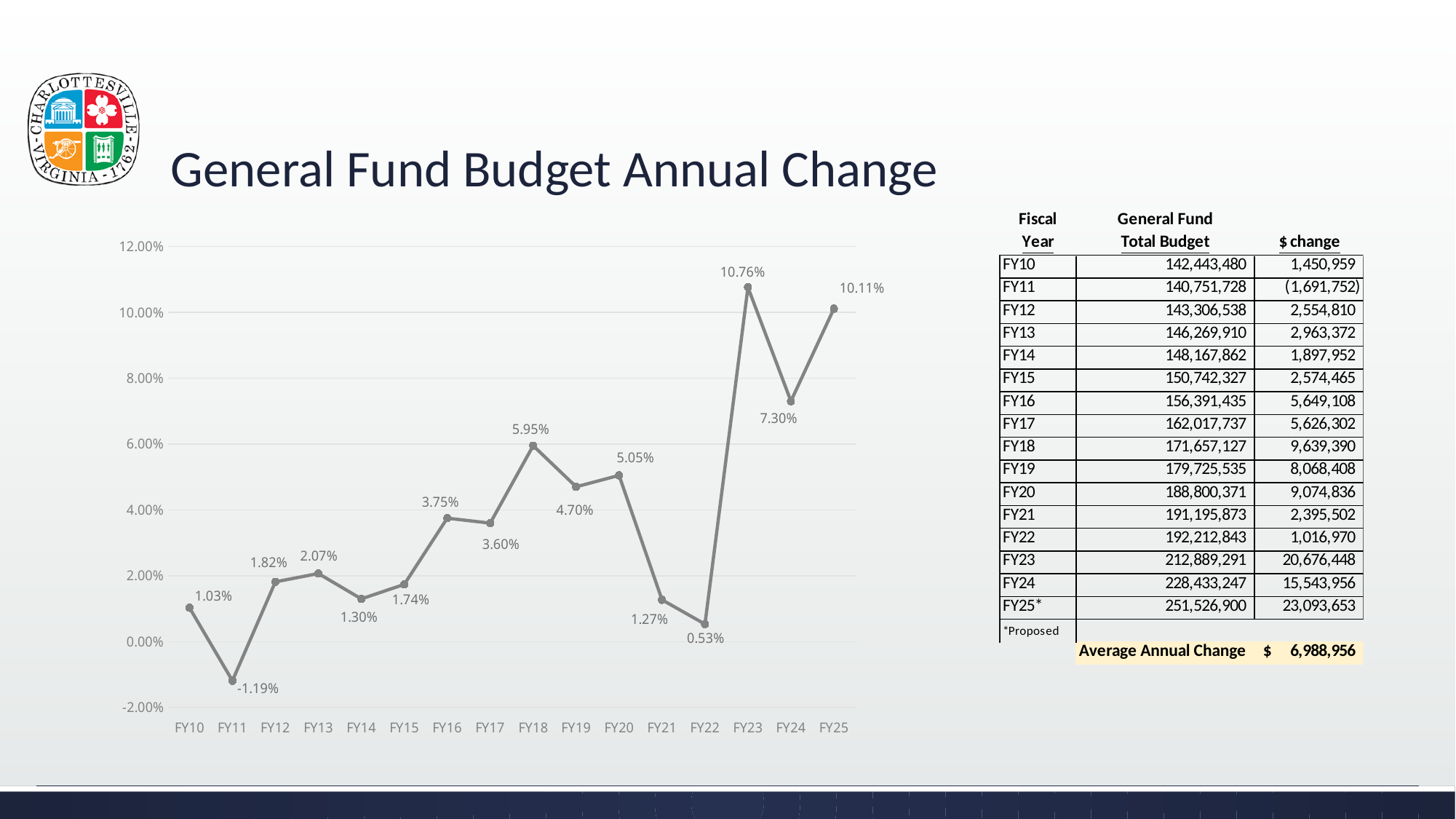
What kind of chart is shown on the slide? Line chart How many fiscal years are plotted on the chart? 16 Which is larger, the annual change for FY18 or for FY20? FY18 What is the annual change value shown for FY11? -1.19% What is the title of the slide containing the chart? General Fund Budget Annual Change What is the difference between the annual change for FY23 and FY24? 3.46% Which fiscal year has the lowest annual change on the chart? FY11 Which fiscal year has the highest annual change on the chart? FY23 Does the annual change rise or fall from FY20 to FY22? Fall What is the annual change value shown for FY18? 5.95% Is the value for FY24 greater or less than 6.00%? greater What is the annual change value shown for FY23? 10.76%